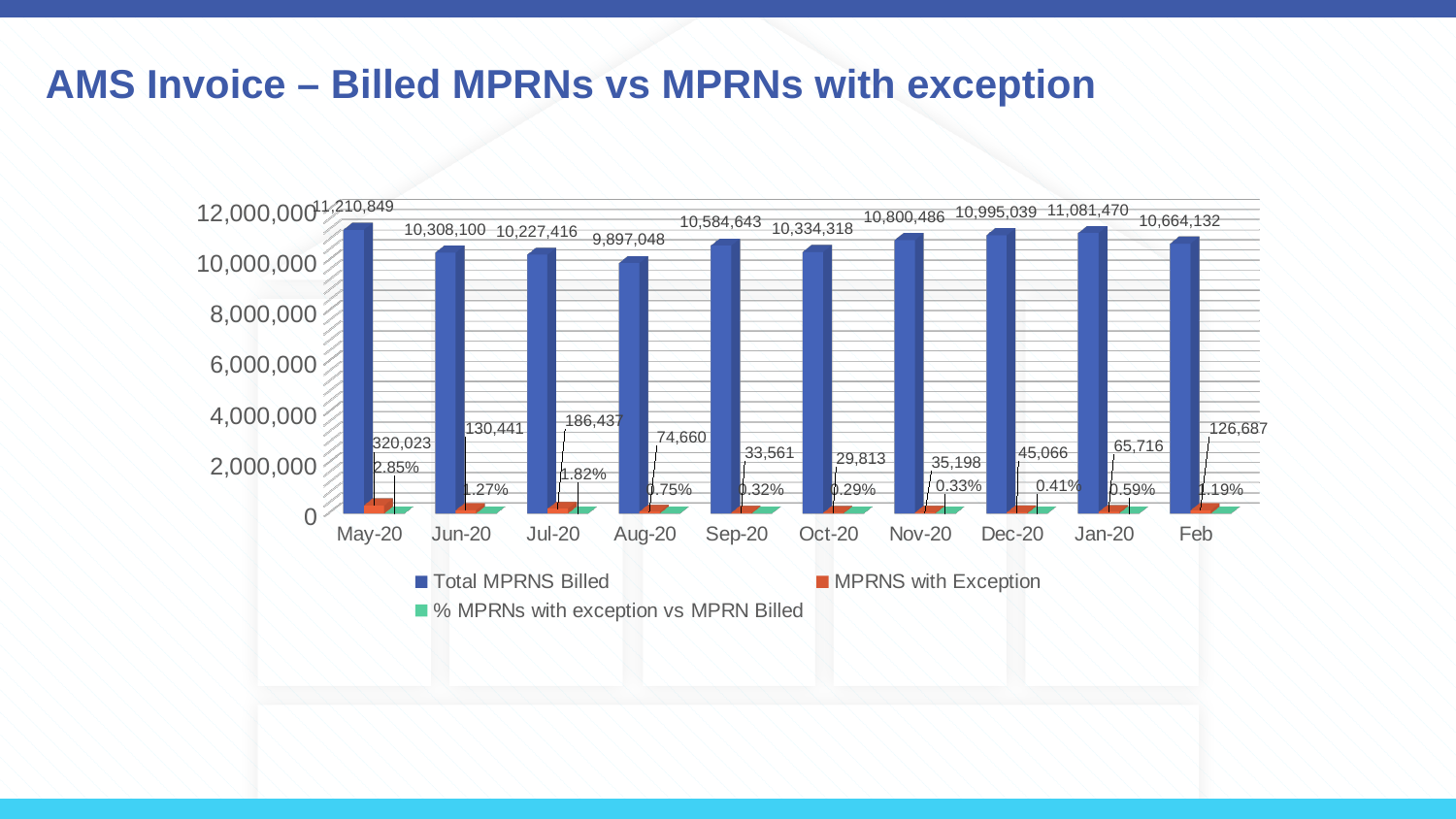
What is the % MPRNs with exception vs MPRN Billed for Jul-20? 1.82% How many months are shown on the x axis? 10 Which month has the lowest Total MPRNS Billed? Aug-20 Which is larger, the MPRNS with Exception value for Feb or for Dec-20? Feb What is the Total MPRNS Billed value for Sep-20? 10,584,643 How many series does the legend list? 3 What is the difference between the Total MPRNS Billed for May-20 and Aug-20? 1,313,801 Which month has the highest Total MPRNS Billed? May-20 Which month has the lowest MPRNS with Exception value? Oct-20 What is the difference between the MPRNS with Exception values for Jul-20 and Jun-20? 55,996 Is the Total MPRNS Billed for Aug-20 greater or less than 10,000,000? less What is the MPRNS with Exception value for Jan-20? 65,716